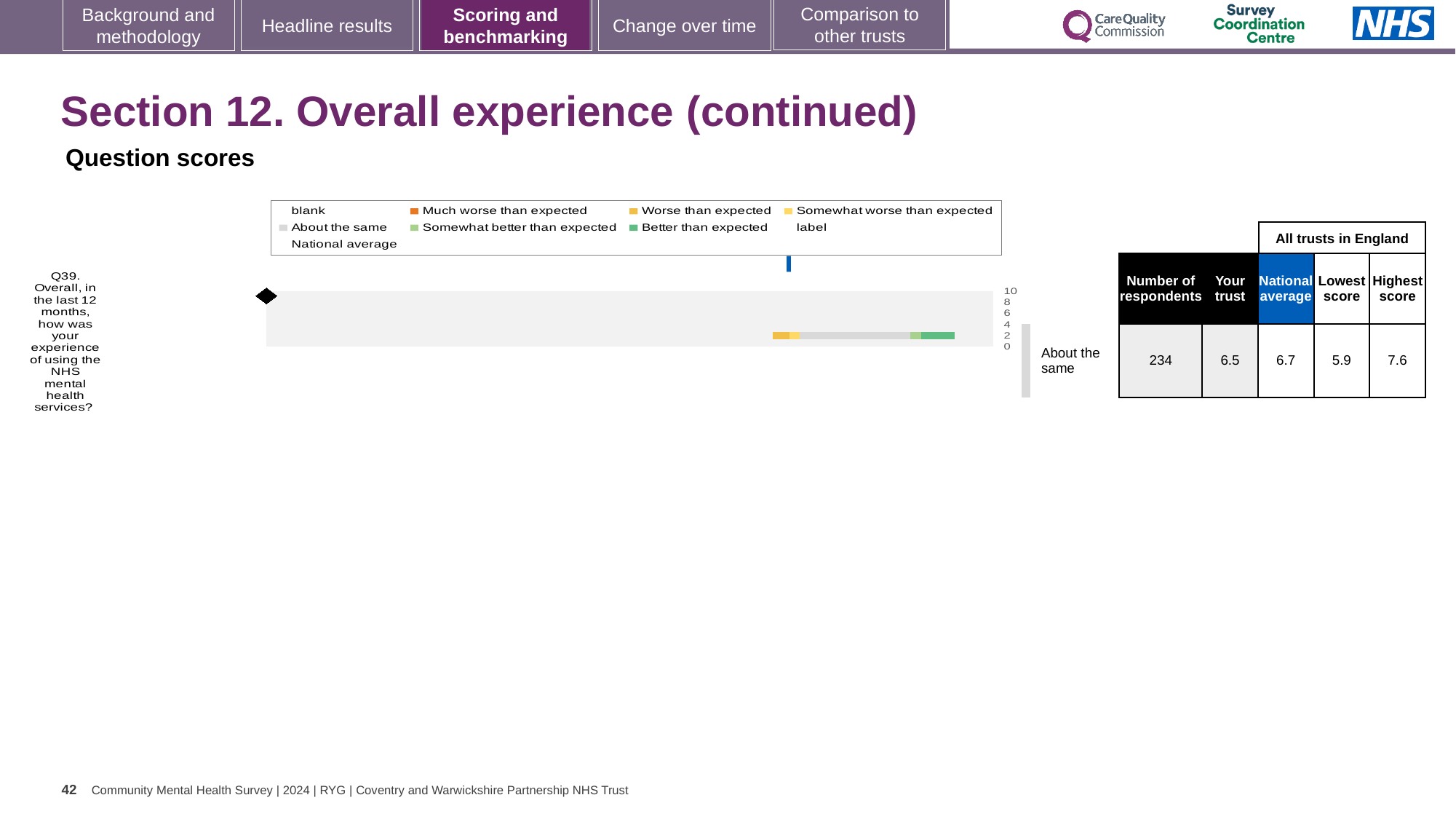
What is the 'Your trust' score for Q39 (Overall, in the last 12 months, how was your experience of using the NHS mental health services?)? 6.5 What is the difference between the highest and lowest trust scores for Q39? 1.7 By how much does the national average exceed the trust's score for Q39? 0.2 What is the lowest score among all trusts in England for Q39? 5.9 How many respondents answered Q39? 234 How many questions are plotted on the chart? 1 What kind of chart is used to show the Q39 question score? Bar chart What is the national average score for Q39? 6.7 Which benchmark category is the trust's Q39 score placed in? About the same What is the highest score among all trusts in England for Q39? 7.6 Which is larger for Q39: the trust's score or the national average? National average Is the trust's score for Q39 greater or less than 6 on the chart's axis? greater